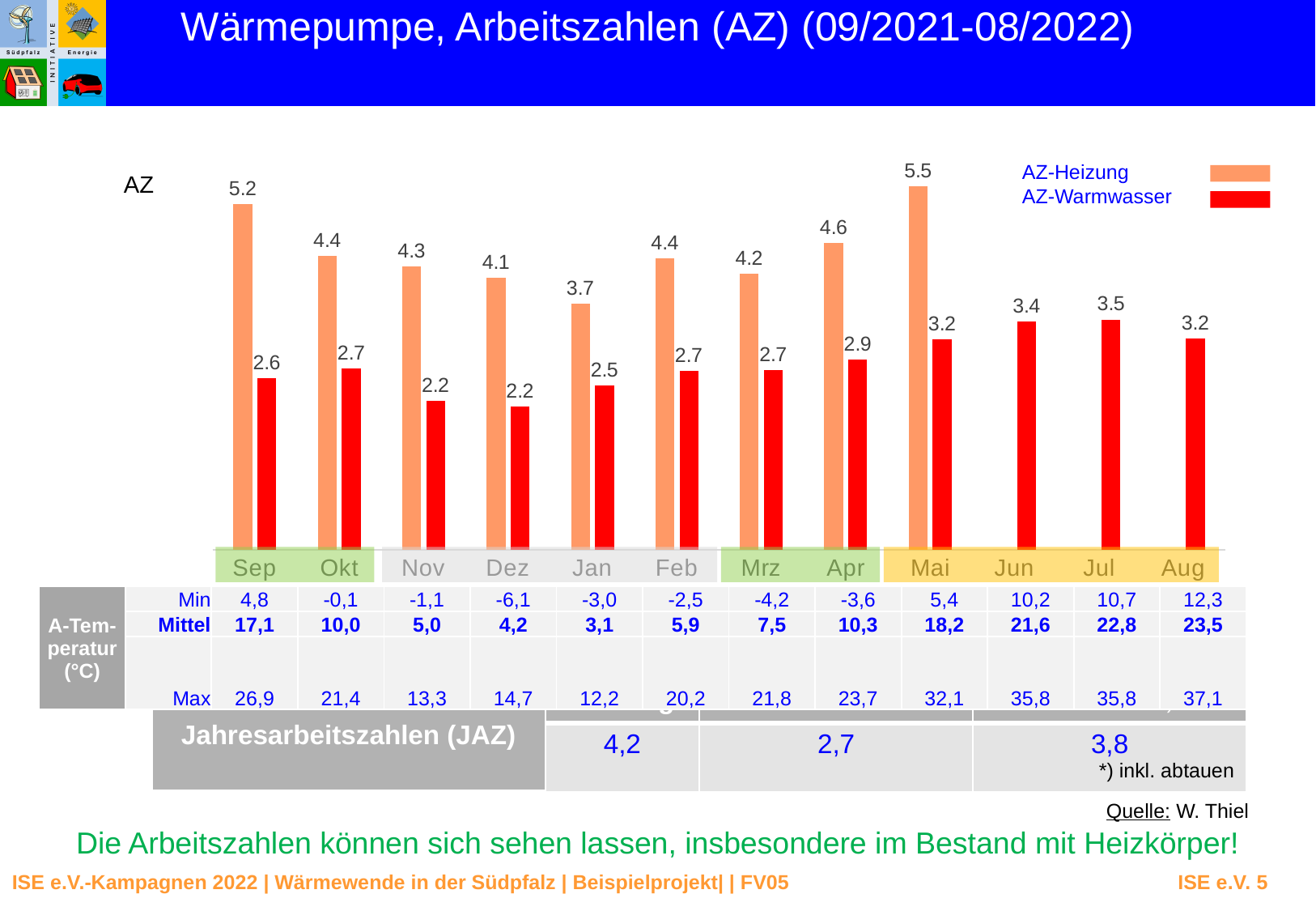
What is the AZ-Warmwasser value for Jul? 3.5 How many series does the chart legend list? 2 Which colour represents AZ-Warmwasser in the chart? Red What kind of chart is shown on the slide? Bar chart What is the AZ-Warmwasser value for Dez? 2.2 Which month has the highest AZ-Heizung value? Mai Which month has the highest AZ-Warmwasser value? Jul What is the AZ-Heizung value for Sep? 5.2 Which is larger, the AZ-Heizung value for Apr or the AZ-Heizung value for Mrz? Apr How many months are shown on the x axis of the chart? 12 Which month has the lowest AZ-Heizung value? Jan What is the difference between the AZ-Heizung and AZ-Warmwasser values for Sep? 2.6